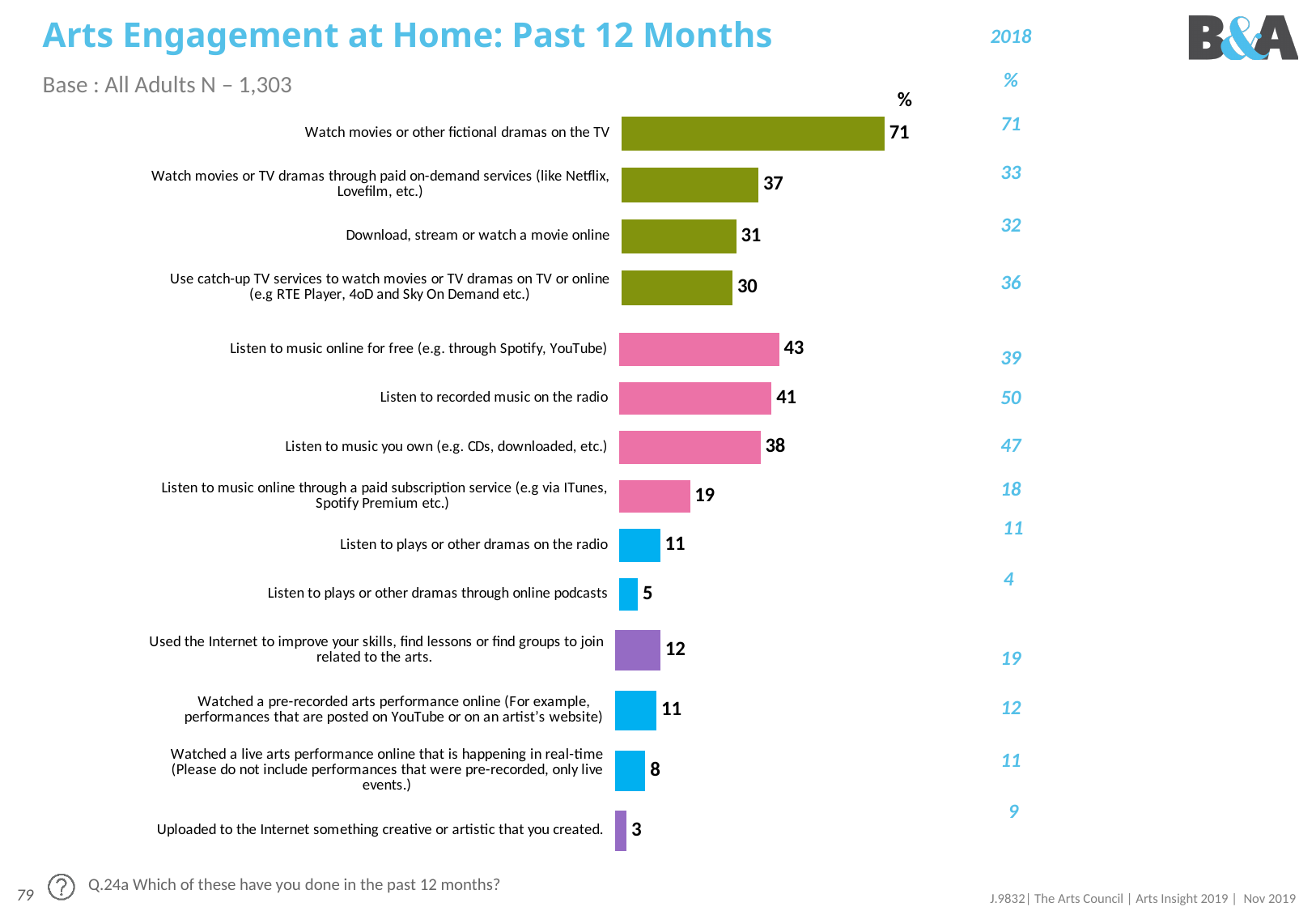
How many activities (bars) are shown in the chart? 14 Which activity has the lowest value in the chart? Uploaded to the Internet something creative or artistic that you created What is the value for 'Uploaded to the Internet something creative or artistic that you created'? 3 What percentage of adults watched movies or other fictional dramas on the TV in the past 12 months? 71 What kind of chart is shown on the slide? bar chart What is the difference between the value for 'Watch movies or other fictional dramas on the TV' and the value for 'Watch movies or TV dramas through paid on-demand services'? 34 What is the value for 'Listen to plays or other dramas through online podcasts'? 5 What is the title of the chart on the slide? Arts Engagement at Home: Past 12 Months What is the value for 'Listen to music online for free (e.g. through Spotify, YouTube)'? 43 What is the 2018 value shown for 'Listen to recorded music on the radio'? 50 Which activity has the highest value in the chart? Watch movies or other fictional dramas on the TV Which is larger: the value for 'Listen to music online for free' or the value for 'Listen to recorded music on the radio'? Listen to music online for free